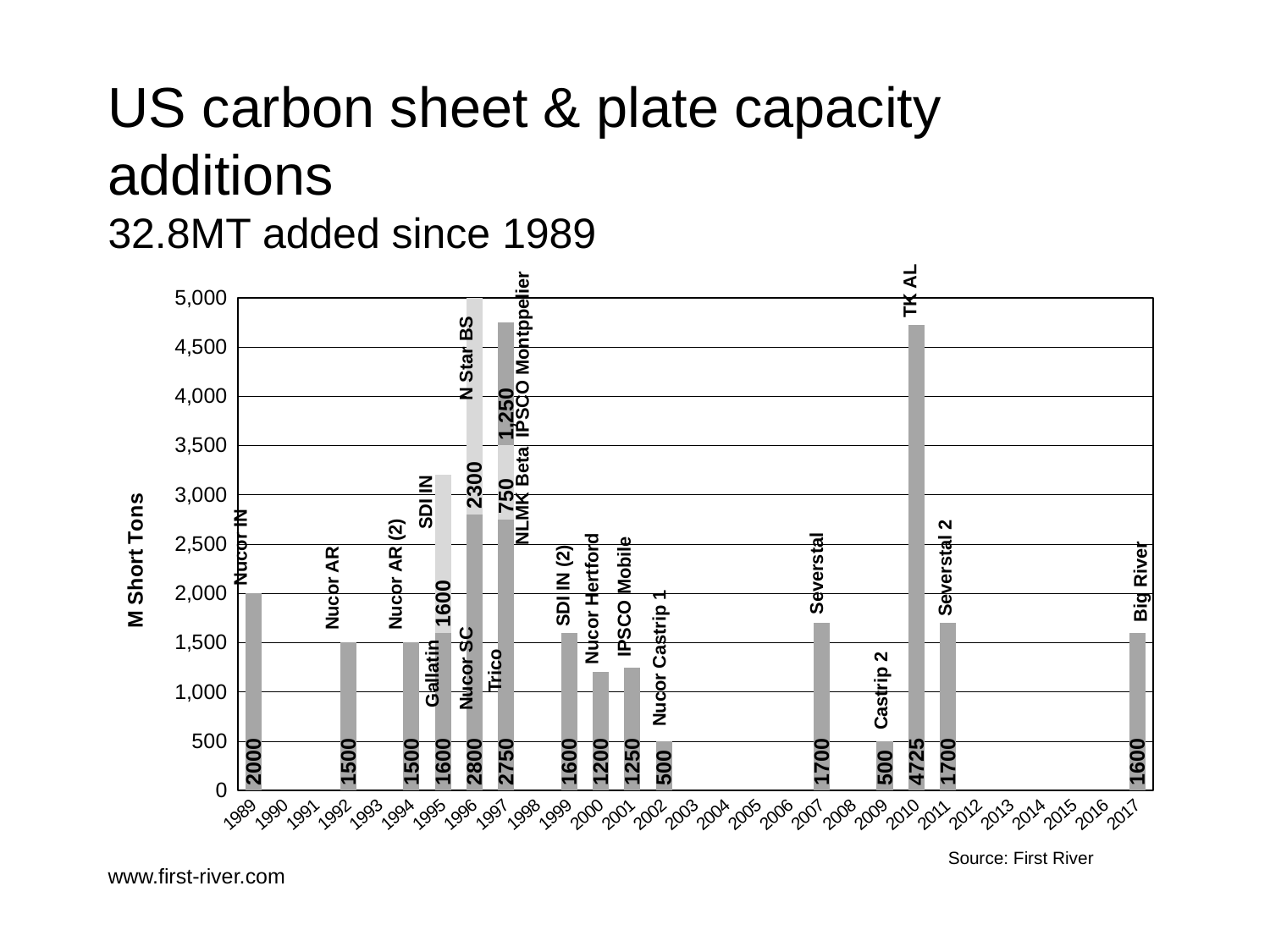
How many years on the x axis have a bar plotted? 15 What is the total of the stacked bar for 1995 (Gallatin plus SDI IN)? 3200 Which year has the tallest bar in the chart? 1996 Which is larger, the bar for 2007 (Severstal) or the bar for 2000 (Nucor Hertford)? 2007 (Severstal) What is the difference between the 2010 bar (4725) and the 2011 bar (1700)? 3025 What is the value labelled for Nucor Hertford in 2000? 1200 What is the total of the stacked bar for 1997 (Trico, NLMK Beta and IPSCO Montpelier)? 4750 What is the capacity addition shown for 2010 (TK AL)? 4725 What kind of chart is shown on the slide? bar chart What is the value of the Big River bar in 2017? 1600 What is the title of the y axis? M Short Tons What is the value of the bar for 1989 (Nucor IN)? 2000